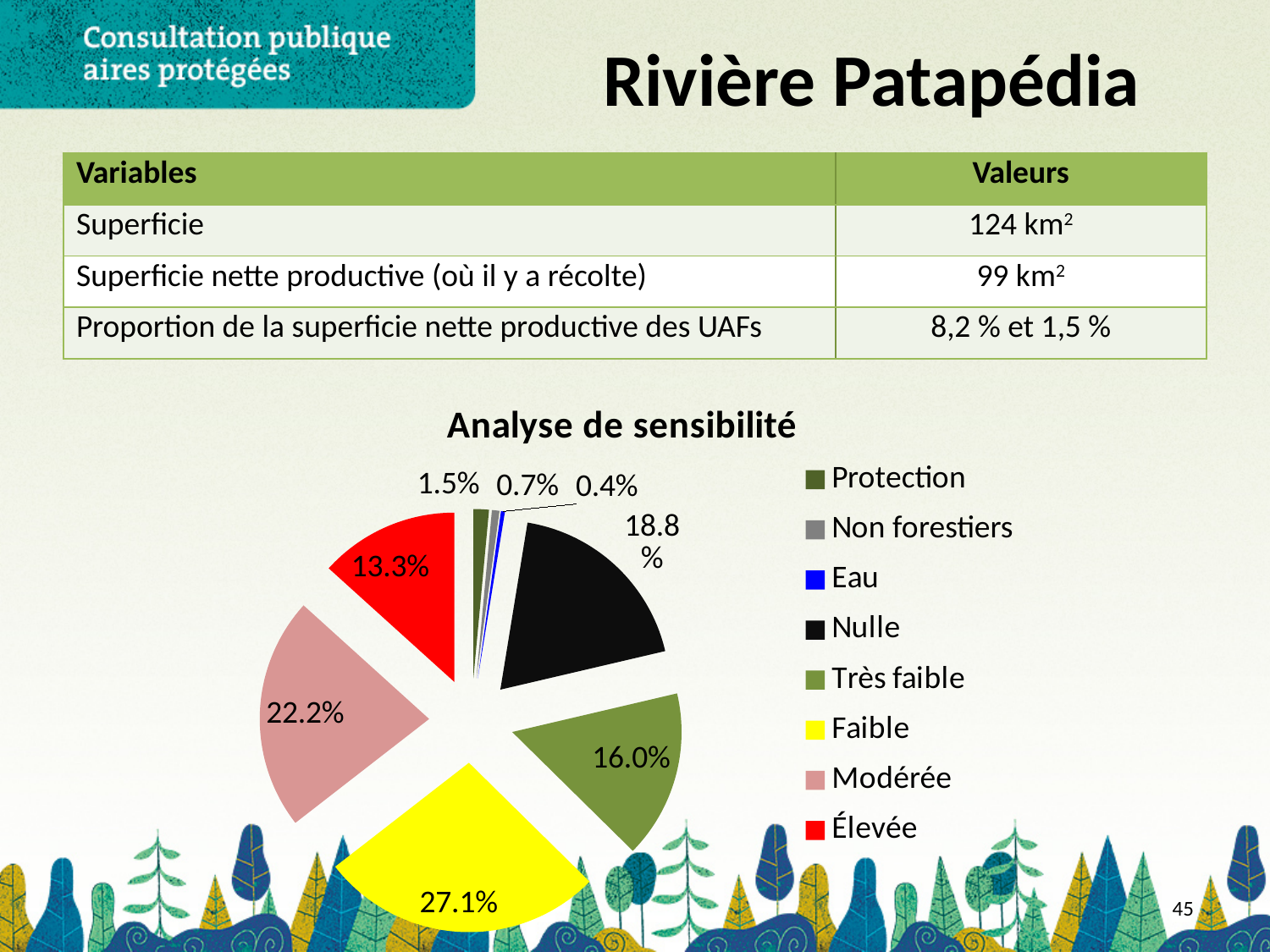
In the 'Analyse de sensibilité' pie chart, what share does the 'Nulle' slice have? 18.8% In the 'Analyse de sensibilité' pie chart, what share does the 'Faible' slice have? 27.1% Which category has the smallest slice in the 'Analyse de sensibilité' pie chart? Eau In the 'Analyse de sensibilité' pie chart, which slice is larger: 'Nulle' or 'Très faible'? Nulle In the 'Analyse de sensibilité' pie chart, what share does the 'Modérée' slice have? 22.2% Which category has the largest slice in the 'Analyse de sensibilité' pie chart? Faible In the 'Analyse de sensibilité' pie chart, what is the difference in percentage points between the 'Faible' and 'Modérée' slices? 4.9 In the 'Analyse de sensibilité' pie chart, what share does the 'Élevée' slice have? 13.3% What kind of chart is shown under the title 'Analyse de sensibilité'? pie chart In the 'Analyse de sensibilité' pie chart, what share does the 'Eau' slice have? 0.4% How many categories does the legend of the 'Analyse de sensibilité' pie chart list? 8 In the 'Analyse de sensibilité' pie chart, what colour is the 'Élevée' slice? red